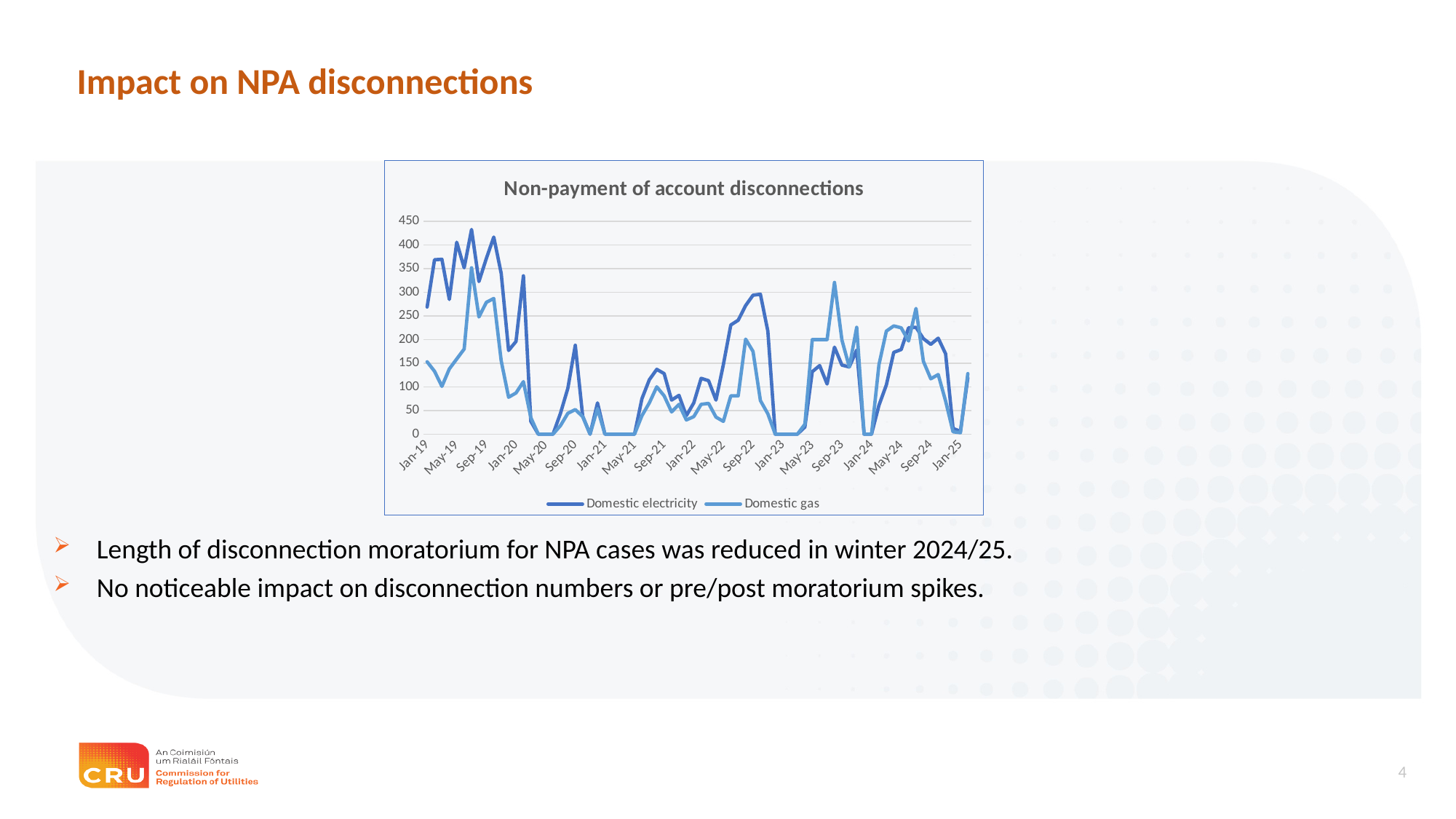
Which series reaches the highest value anywhere on the chart? Domestic electricity How many series does the legend of the chart list? 2 What type of chart is shown on the slide? Line chart What is the title of the chart? Non-payment of account disconnections Is the value for Domestic electricity at May-20 greater or less than 50? less Is the value for Domestic gas at Jan-25 greater or less than 100? less Is the peak value for Domestic electricity around Sep-19 greater or less than 400? greater At Sep-19, which series has the larger value, Domestic electricity or Domestic gas? Domestic electricity Does the Domestic gas line rise or fall between Jan-23 and Sep-23? Rise At Sep-23, which series has the larger value, Domestic electricity or Domestic gas? Domestic gas Which two series are listed in the chart legend? Domestic electricity and Domestic gas